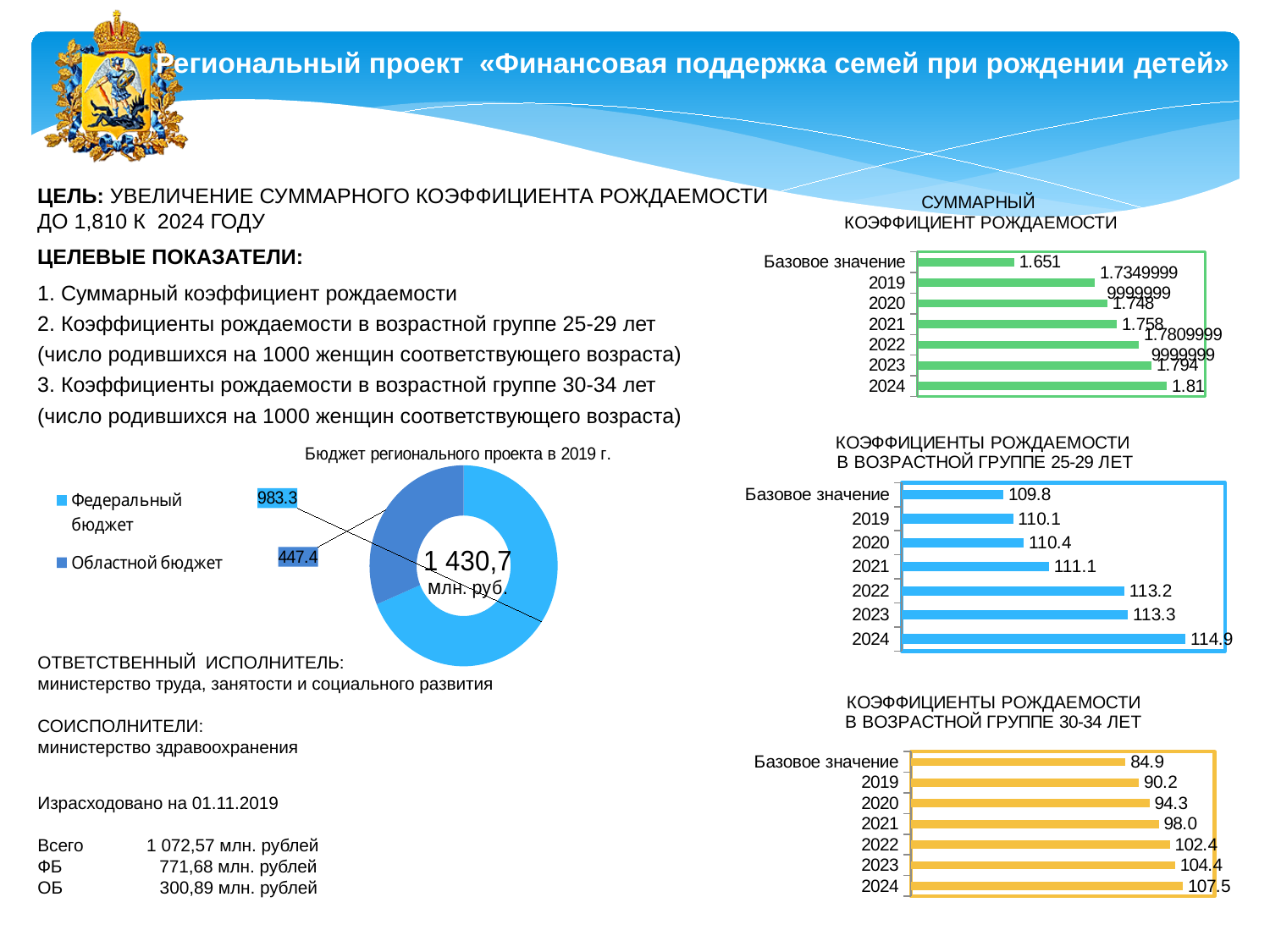
How many categories are shown in the chart 'Коэффициенты рождаемости в возрастной группе 25-29 лет'? 7 In the chart 'Суммарный коэффициент рождаемости', what is the value for 'Базовое значение'? 1.651 In the chart 'Суммарный коэффициент рождаемости', what is the value for 2024? 1.81 In the chart 'Коэффициенты рождаемости в возрастной группе 25-29 лет', what is the value for 'Базовое значение'? 109.8 In the chart 'Коэффициенты рождаемости в возрастной группе 25-29 лет', what is the value for 2024? 114.9 In the chart 'Коэффициенты рождаемости в возрастной группе 30-34 лет', what is the value for 2021? 98.0 In the chart 'Суммарный коэффициент рождаемости', do the values rise or fall from 'Базовое значение' to 2024? rise In the chart 'Бюджет регионального проекта в 2019 г.', what is the value for 'Федеральный бюджет'? 983.3 In the chart 'Коэффициенты рождаемости в возрастной группе 30-34 лет', what is the difference between the values for 2024 and 2019? 17.3 In the chart 'Коэффициенты рождаемости в возрастной группе 30-34 лет', which category has the lowest value? Базовое значение What kind of chart is 'Бюджет регионального проекта в 2019 г.'? doughnut chart In the chart 'Бюджет регионального проекта в 2019 г.', which is larger: 'Федеральный бюджет' or 'Областной бюджет'? Федеральный бюджет